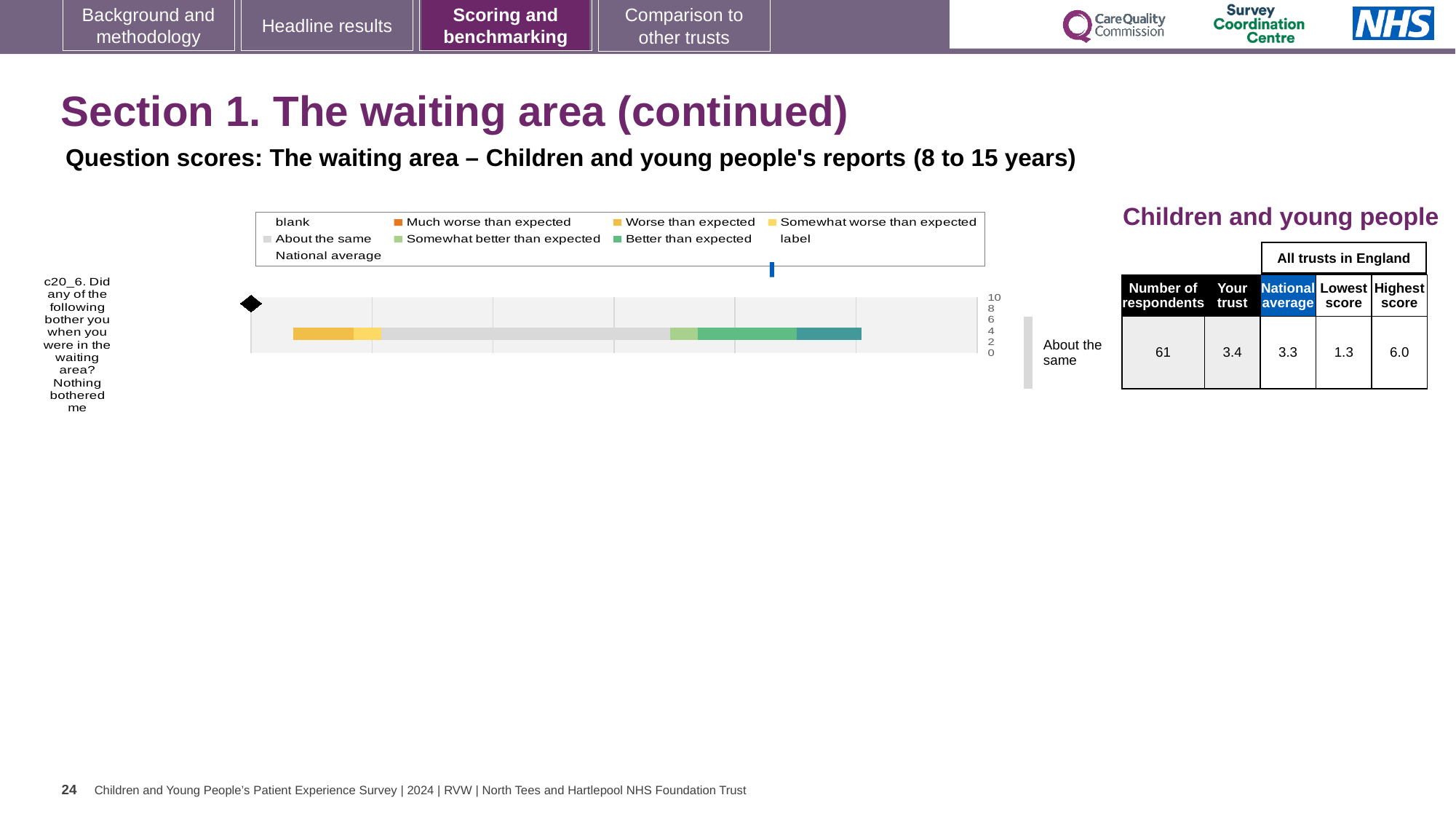
What kind of chart is used to show the benchmarking result for question c20_6? bar chart What is the difference between the highest and lowest scores for question c20_6? 4.7 What is the 'Your trust' score for question c20_6 in the table? 3.4 Which is larger for question c20_6, the trust's score or the national average? the trust's score How many respondents answered question c20_6? 61 What is the title of the table to the right of the chart? Children and young people What is the highest score among all trusts in England for question c20_6? 6.0 How many survey questions are plotted on the chart? 1 What benchmarking category is the trust's result for question c20_6 placed in? About the same What is the lowest score among all trusts in England for question c20_6? 1.3 What is the national average score for question c20_6? 3.3 What is the difference between the trust's score and the national average for question c20_6? 0.1